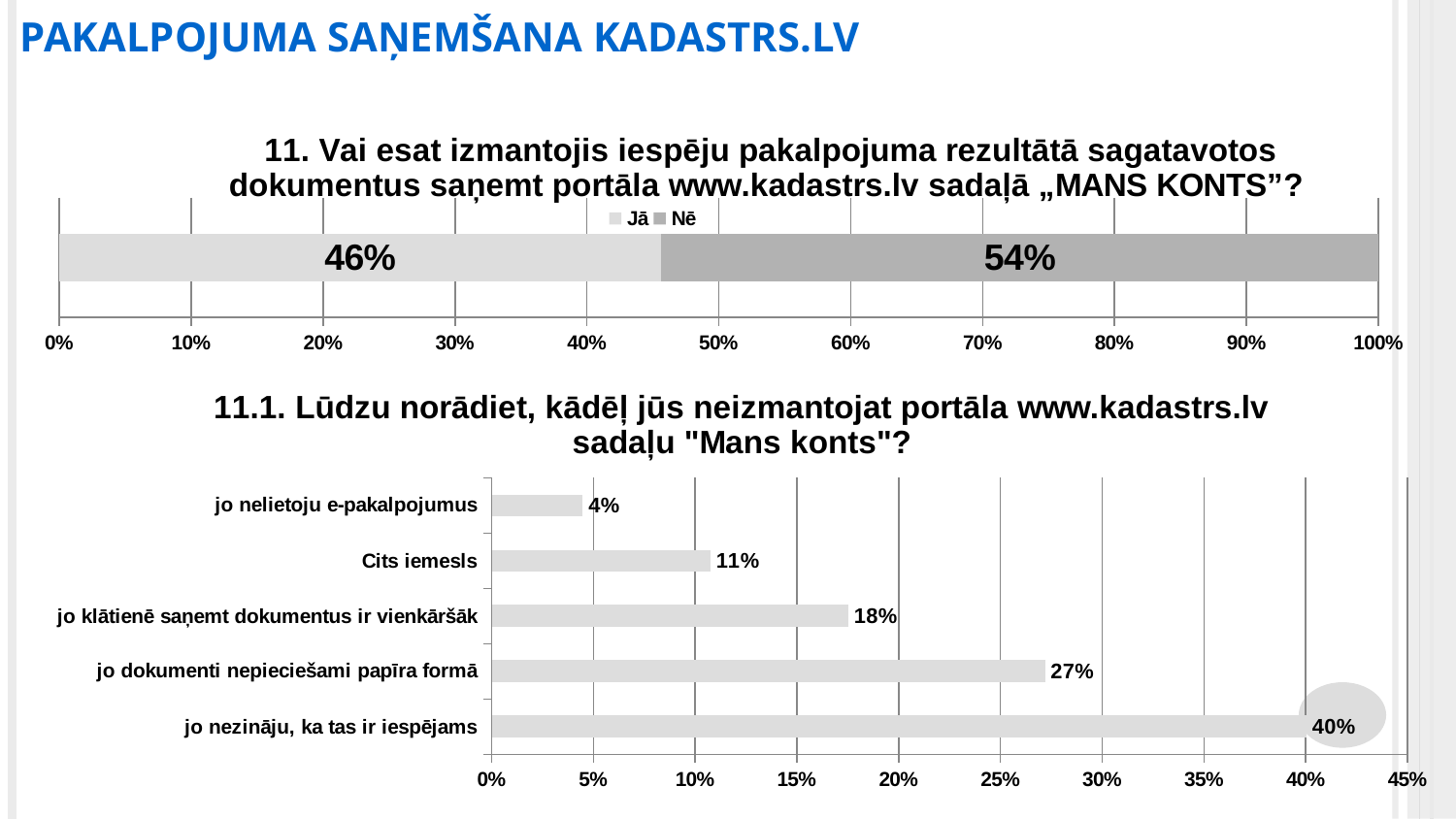
In the top chart (question 11), what percentage of respondents answered "Jā"? 46% In the bottom chart (question 11.1), which reason has the lowest value? jo nelietoju e-pakalpojumus In the bottom chart (question 11.1), what is the value for "jo dokumenti nepieciešami papīra formā"? 27% In the top chart (question 11), how many series does the legend list? 2 In the bottom chart (question 11.1), what is the difference between "jo klātienē saņemt dokumentus ir vienkāršāk" and "Cits iemesls"? 7% In the top chart (question 11), which answer has the larger share, "Jā" or "Nē"? Nē In the top chart (question 11), what is the difference between the "Nē" and "Jā" shares? 8% In the top chart (question 11), what percentage of respondents answered "Nē"? 54% In the bottom chart (question 11.1), which reason has the highest value? jo nezināju, ka tas ir iespējams What type of chart is the bottom chart (question 11.1)? Bar chart In the bottom chart (question 11.1), what is the value for "jo nezināju, ka tas ir iespējams"? 40% In the bottom chart (question 11.1), how many reasons (categories) are shown? 5